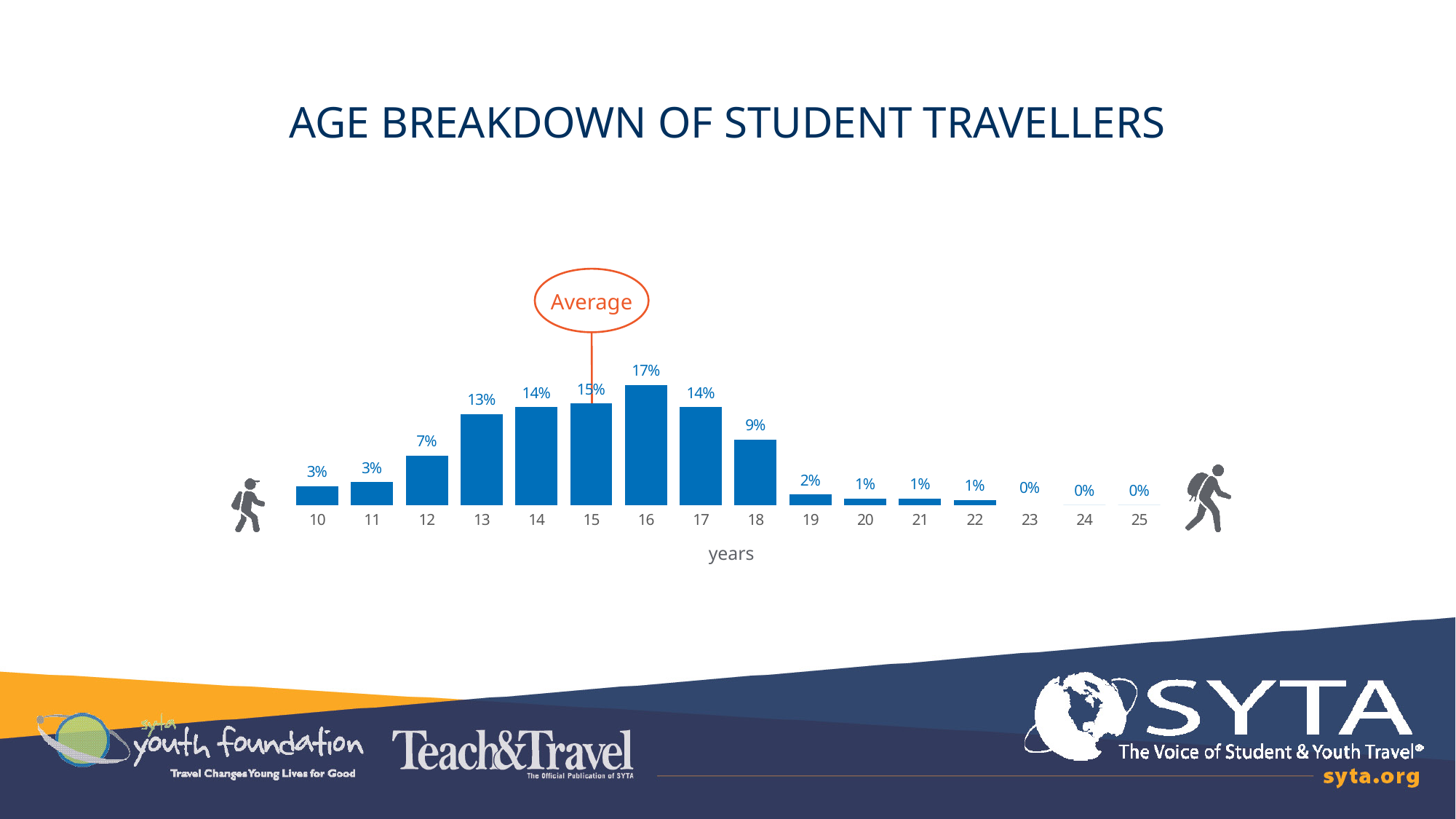
What is the difference between the share for age 13 and the share for age 12? 6% Which age is marked as the average on the chart? 15 How many age categories are shown on the x axis? 16 What percentage of student travellers are 12 years old? 7% Which age has the highest share of student travellers? 16 What percentage of student travellers are 16 years old? 17% What is the title of the chart? AGE BREAKDOWN OF STUDENT TRAVELLERS What is the difference between the share for age 16 and the share for age 18? 8% Which is larger, the share for age 14 or the share for age 19? age 14 What percentage of student travellers are 18 years old? 9% Do the values rise or fall from age 16 to age 22? fall What kind of chart is shown on the slide? bar chart